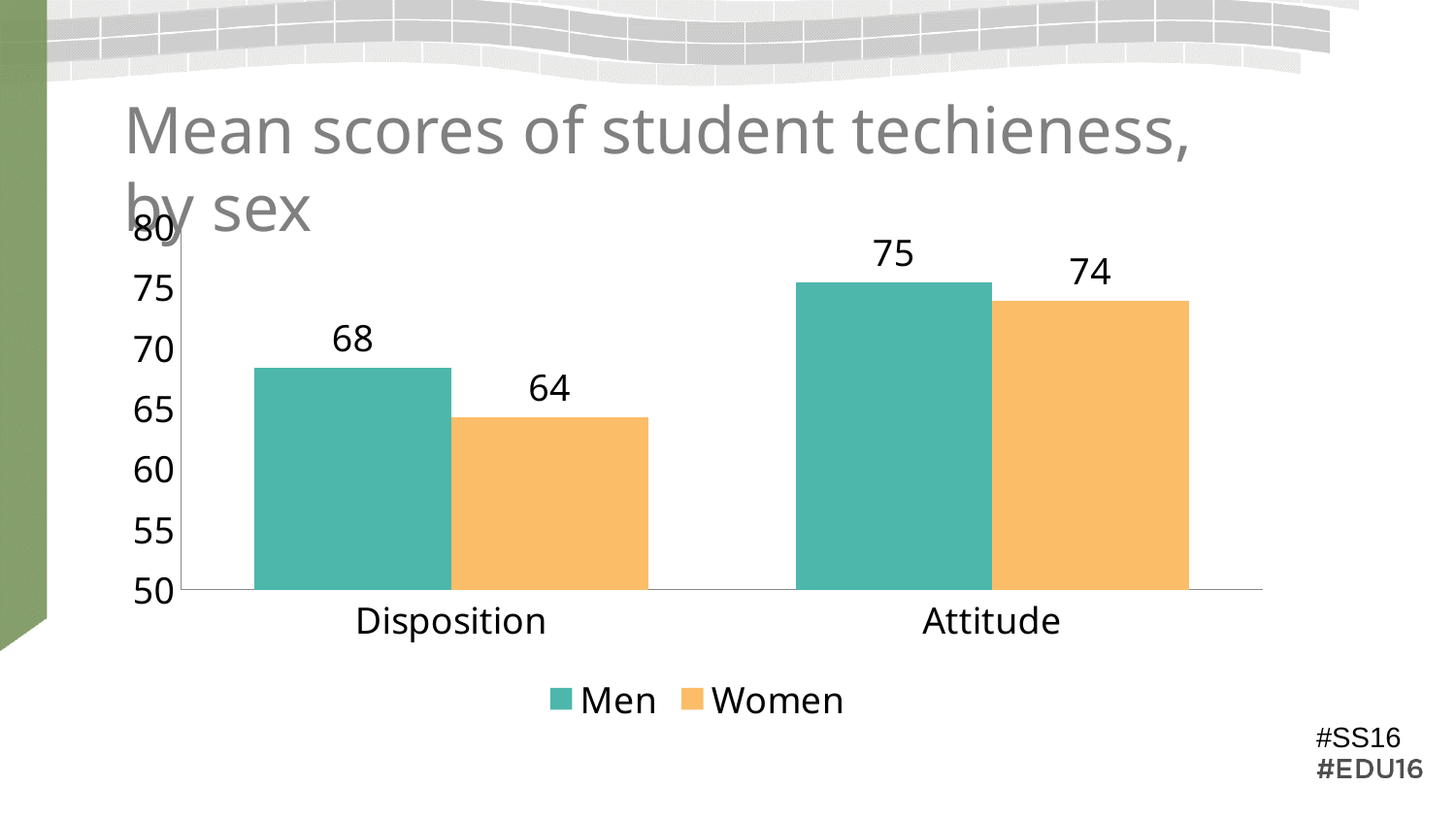
What is the mean score for Women on Attitude? 74 What kind of chart is shown on the slide? Bar chart Which is larger, the Women score on Attitude or the Men score on Disposition? Women score on Attitude What is the mean score for Men on Disposition? 68 What is the difference between the Men scores on Attitude and Disposition? 7 What is the title of the chart? Mean scores of student techieness, by sex Which series has the lowest score on Disposition? Women How many categories are shown on the x axis? 2 How many series does the legend list? 2 What is the mean score for Women on Disposition? 64 What is the difference between the Men and Women scores on Disposition? 4 Which category has the highest score for Men? Attitude